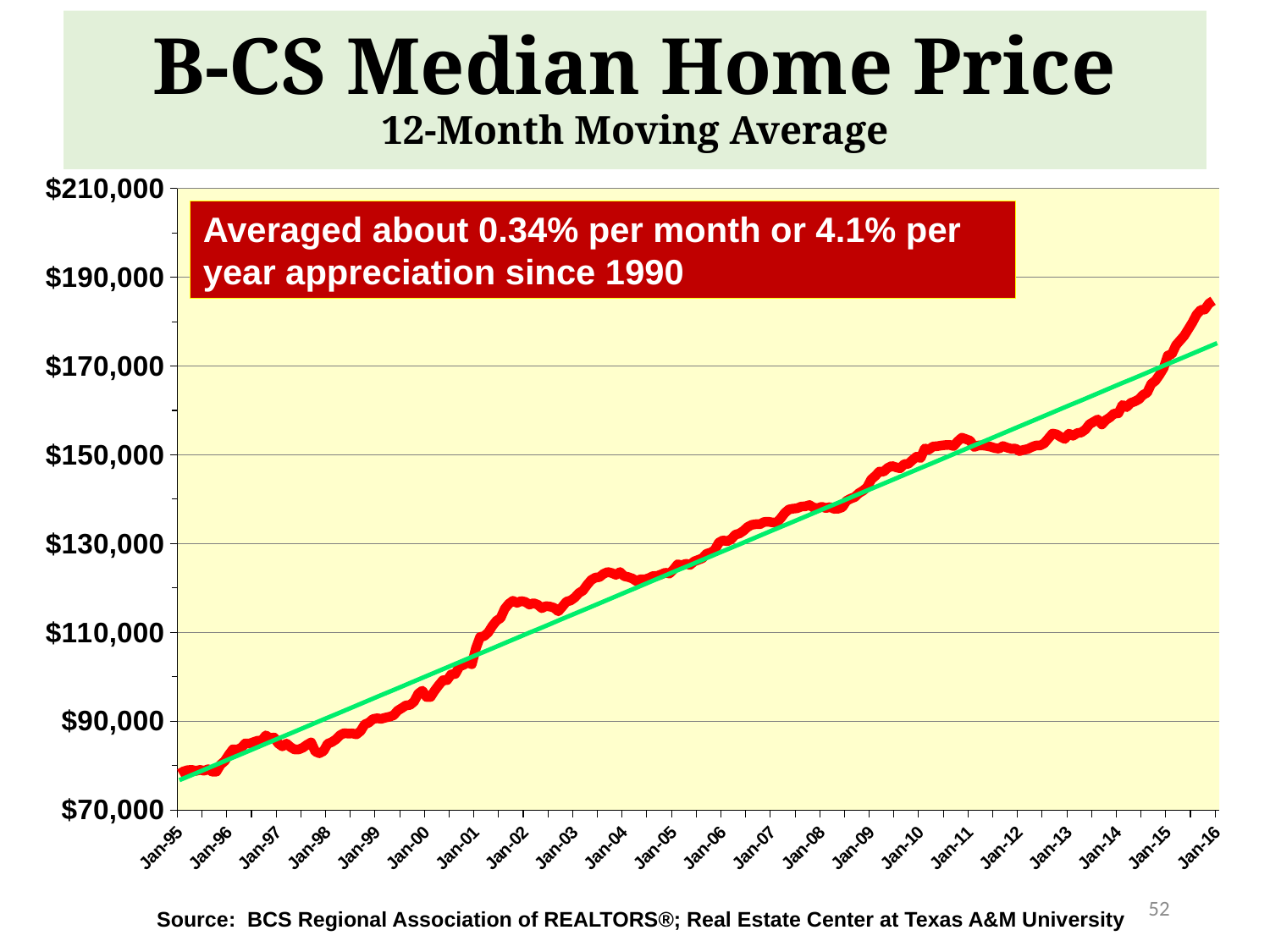
Is the value for Jan-02 greater or less than $110,000? greater Is the value for Jan-16 greater or less than $170,000? greater According to the annotation box, what was the average annual appreciation since 1990? 4.1% Is the value for Jan-95 greater or less than $90,000? less Which is higher, the value for Jan-16 or the value for Jan-11? Jan-16 What is the title of the chart? B-CS Median Home Price Does the median home price generally rise or fall from Jan-95 to Jan-16? rise How many year labels are shown on the x axis? 22 What kind of chart is shown on the slide? line chart